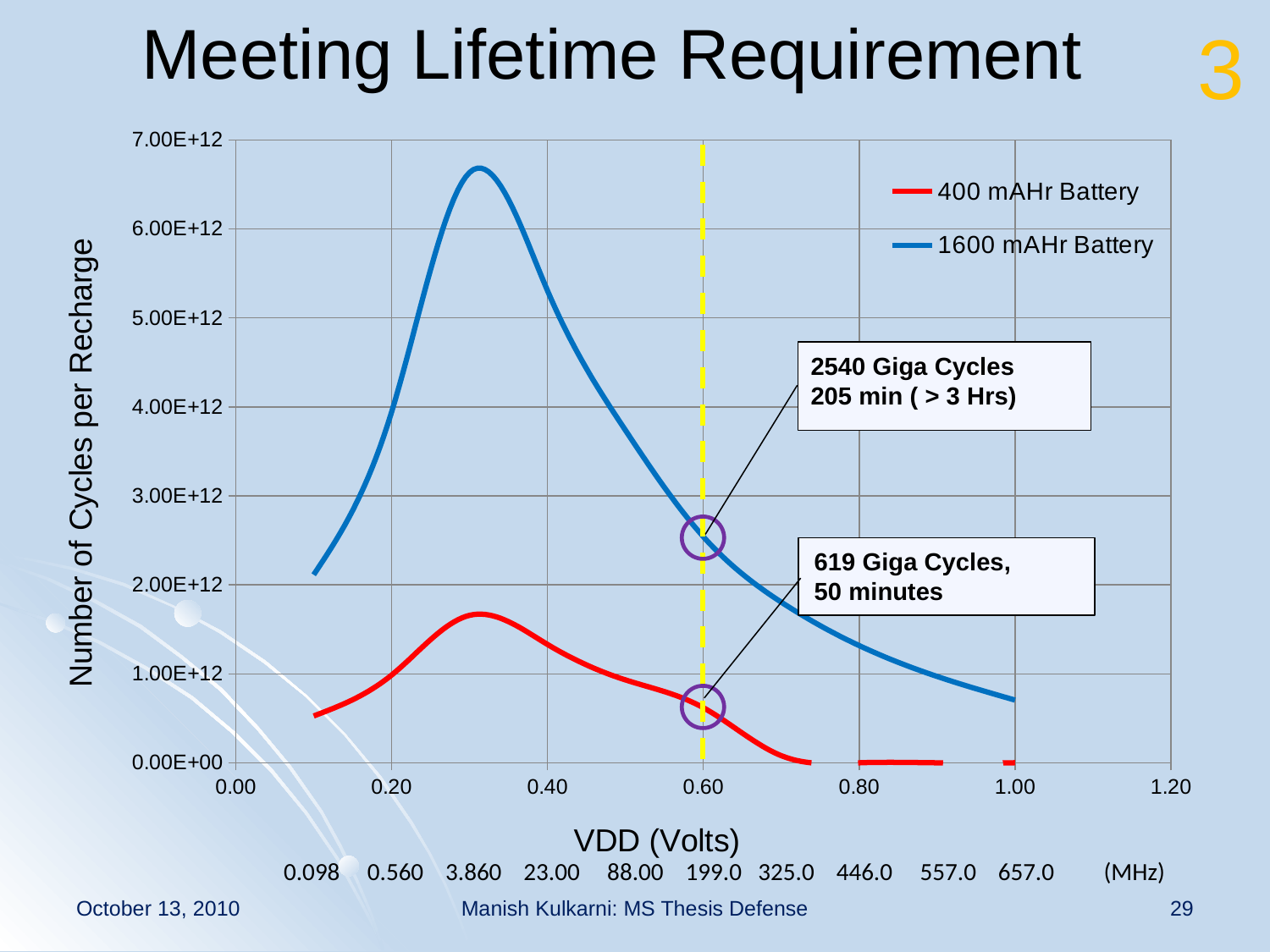
According to the annotation, how many cycles does the 400 mAHr Battery provide at the marked point (0.60 V)? 619 Giga Cycles After its peak near 0.30 V, does the 1600 mAHr Battery curve rise or fall as VDD increases? fall According to the annotation, how many minutes of runtime does the 1600 mAHr Battery give at the marked point? 205 min According to the annotation, how many cycles does the 1600 mAHr Battery provide at the marked point (0.60 V)? 2540 Giga Cycles What is the label of the x axis? VDD (Volts) Is the peak value of the 400 mAHr Battery curve greater or less than 2.00E+12? less At VDD = 0.60 V, which series has the higher number of cycles per recharge, the 400 mAHr Battery or the 1600 mAHr Battery? 1600 mAHr Battery How many series does the legend list? 2 What kind of chart is shown on the slide? line chart What are the two series named in the legend? 400 mAHr Battery and 1600 mAHr Battery Is the peak value of the 1600 mAHr Battery curve greater or less than 6.00E+12? greater According to the annotation, how many minutes of runtime does the 400 mAHr Battery give at the marked point? 50 minutes